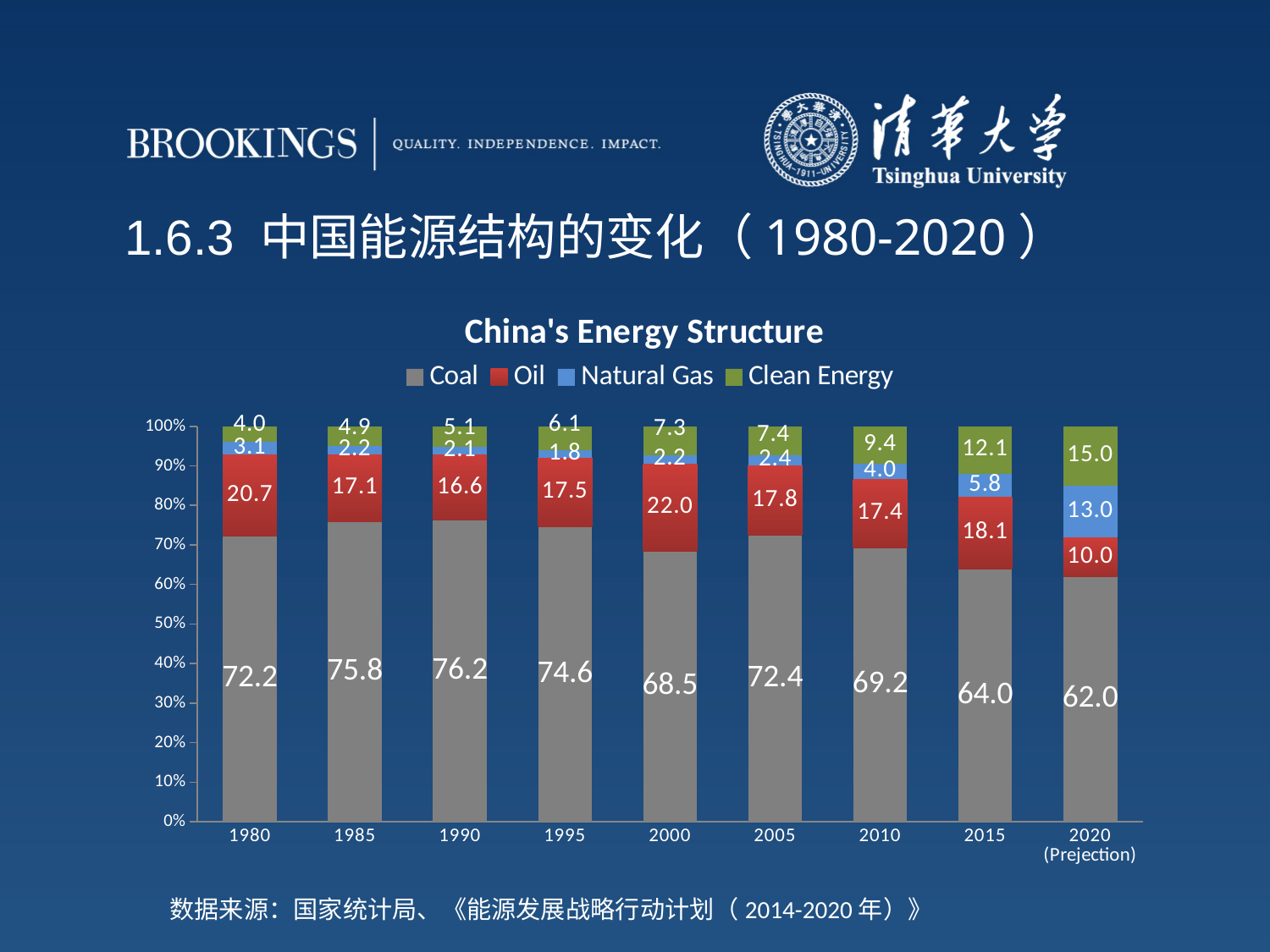
Does the Clean Energy share rise or fall from 1980 to 2020? Rise What is the Clean Energy value for 2015? 12.1 What is the difference between the Coal value in 1980 and in 2020 (Prejection)? 10.2 What kind of chart is this? Stacked bar chart What is the Natural Gas value for 2020 (Prejection)? 13.0 What is the Oil value for 2000? 22.0 What is the Coal value for 1990? 76.2 Which is larger, the Oil value in 1985 or in 2005? 2005 How many years are shown on the x axis? 9 How many series does the legend list? 4 In which year is the Natural Gas share lowest? 1995 In which year is the Coal share highest? 1990